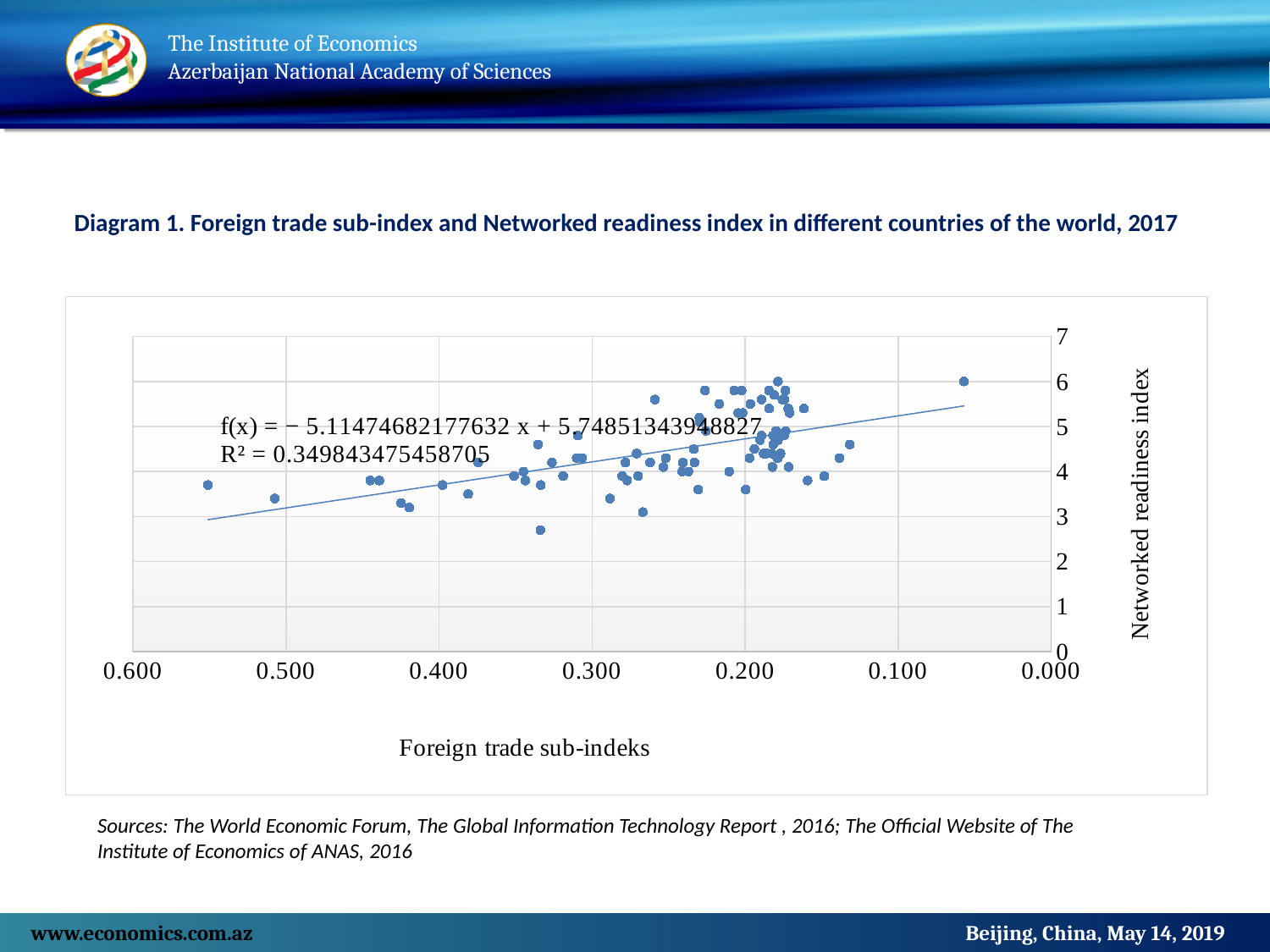
Is the slope of the fitted line in the printed equation positive or negative? negative Does the fitted trendline rise or fall when read from left to right across the chart? rise What R² value is printed on the chart? R² = 0.349843475458705 What is the intercept in the fitted equation f(x) printed on the chart? 5.74851343948827 What is the label of the vertical axis of the chart? Networked readiness index What kind of chart is shown on the slide? scatter plot What is the leftmost tick label on the horizontal axis of the chart? 0.600 Is the Networked readiness index of the lowest plotted point greater or less than 3? less What is the slope coefficient in the fitted equation f(x) printed on the chart? − 5.11474682177632 What is the highest value shown on the vertical axis of the chart? 7 What is the title of the chart on the slide? Diagram 1. Foreign trade sub-index and Networked readiness index in different countries of the world, 2017 Is the Networked readiness index of the highest plotted point greater or less than 5? greater